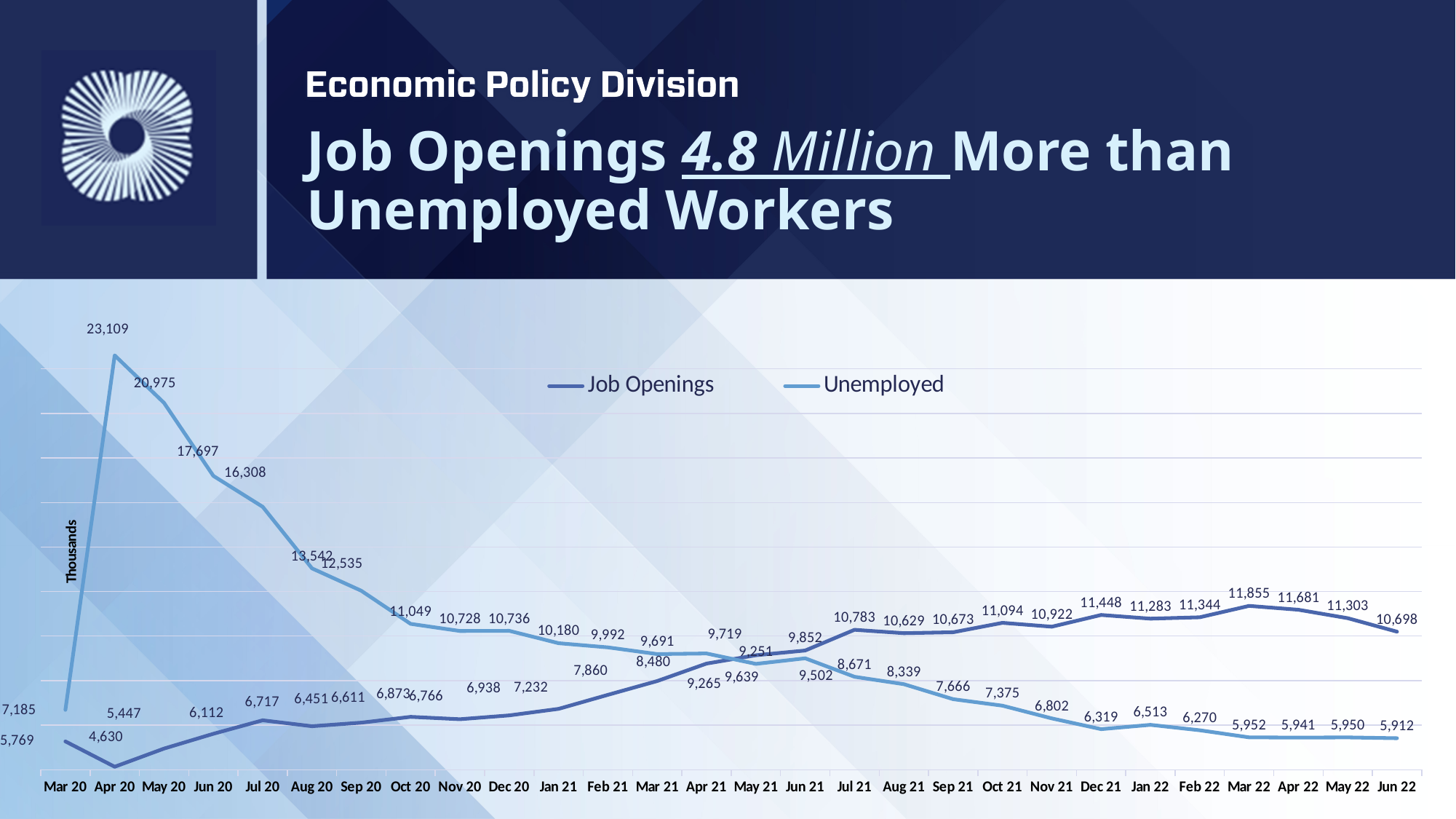
What is the Unemployed value for Apr 20? 23,109 In which month does the Job Openings series reach its lowest value? Apr 20 What is the difference between Job Openings and Unemployed in Jun 22? 4,786 In which month does the Unemployed series reach its highest value? Apr 20 How many months are shown on the x axis? 28 Does the Unemployed series generally rise or fall from Apr 20 to Jun 22? Fall How many series does the legend list? 2 Which series has the larger value in Mar 21, Job Openings or Unemployed? Unemployed What is the Job Openings value for Jun 22? 10,698 What is the Unemployed value for Jun 22? 5,912 In which month does the Job Openings series reach its highest value? Mar 22 What type of chart is shown on the slide? Line chart